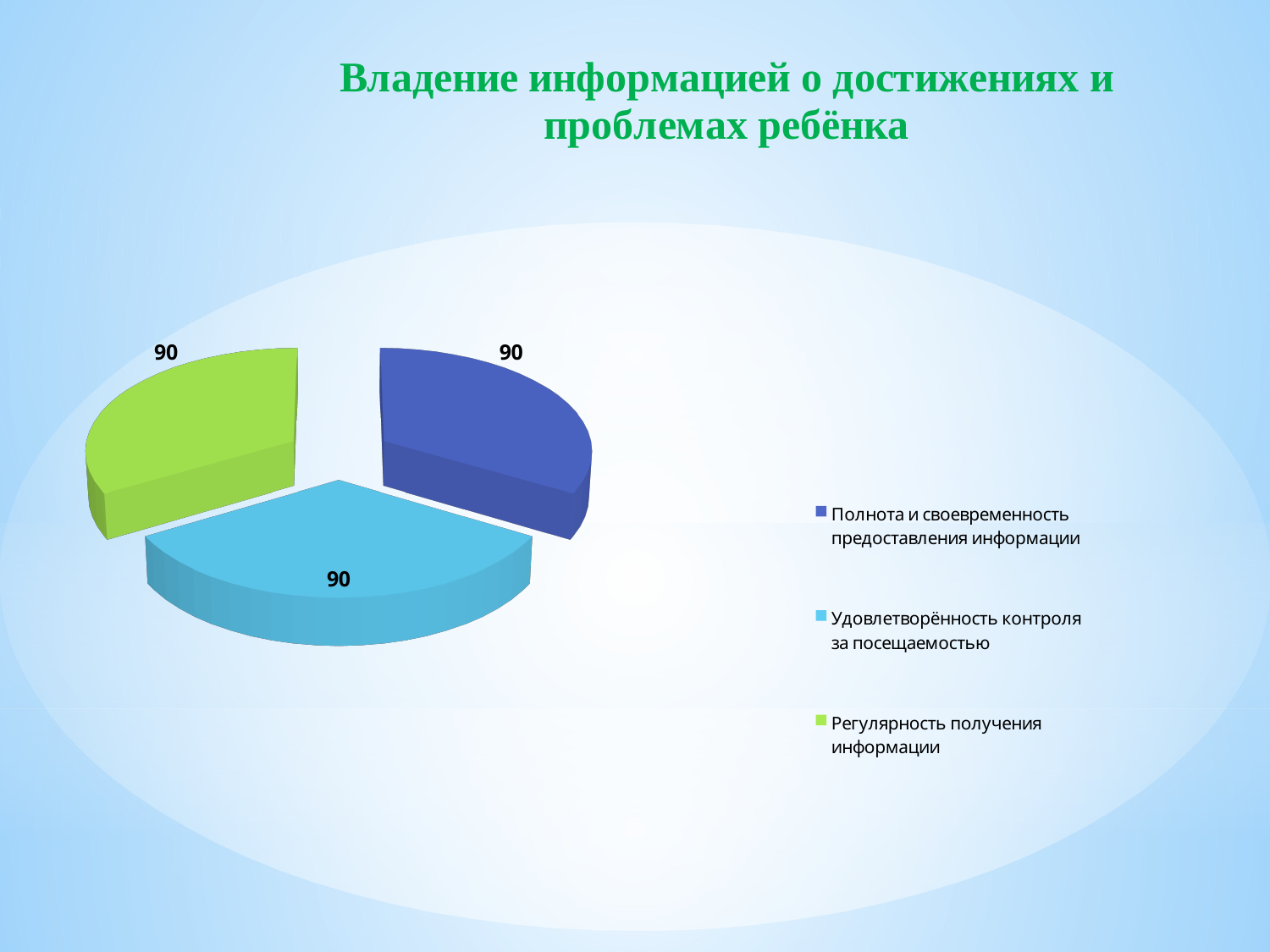
Are all three slices of the pie chart labelled with the same value? Yes What is the difference between the values for "Полнота и своевременность предоставления информации" and "Регулярность получения информации"? 0 What is the value shown for the slice "Регулярность получения информации"? 90 What is the value shown for the slice "Удовлетворённость контроля за посещаемостью"? 90 How many slices does the pie chart have? 3 Which colour represents "Регулярность получения информации" in the legend? Green What is the total of all the values shown on the pie chart? 270 What is the title of the chart on the slide? Владение информацией о достижениях и проблемах ребёнка What is the value shown for the slice "Полнота и своевременность предоставления информации"? 90 How many entries does the legend list? 3 What kind of chart is shown on the slide? Pie chart